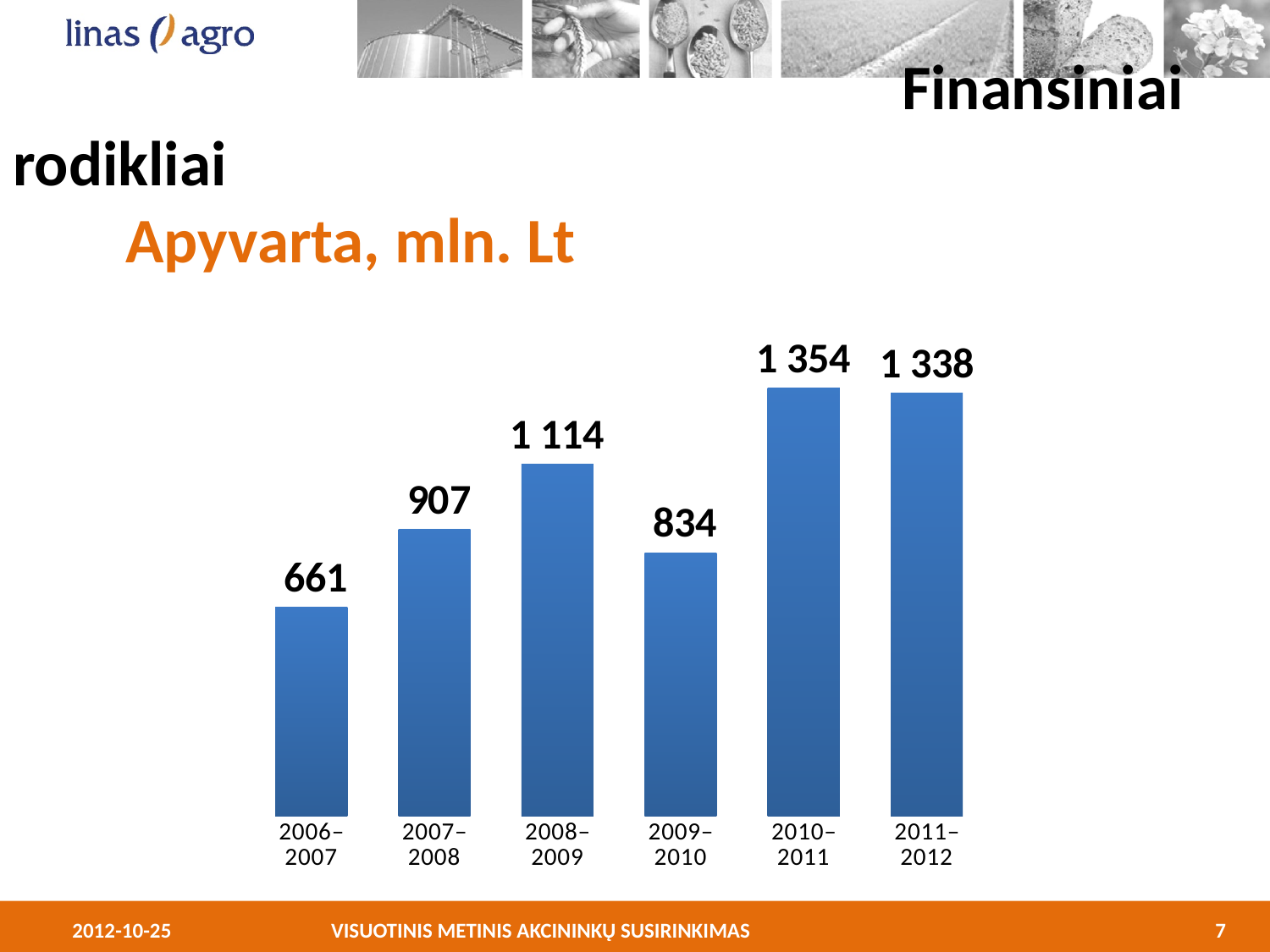
What is the value for 2011–2012? 1 338 What is the difference between the values for 2008–2009 and 2009–2010? 280 Does the value rise or fall from 2008–2009 to 2009–2010? fall What is the difference between the values for 2010–2011 and 2011–2012? 16 Which is larger, the value for 2007–2008 or the value for 2009–2010? 2007–2008 How many periods are shown on the chart? 6 What is the value for 2009–2010? 834 What kind of chart is shown on the slide? bar chart What is the title of the chart? Apyvarta, mln. Lt What is the value for 2006–2007? 661 Which period has the highest value? 2010–2011 Which period has the lowest value? 2006–2007